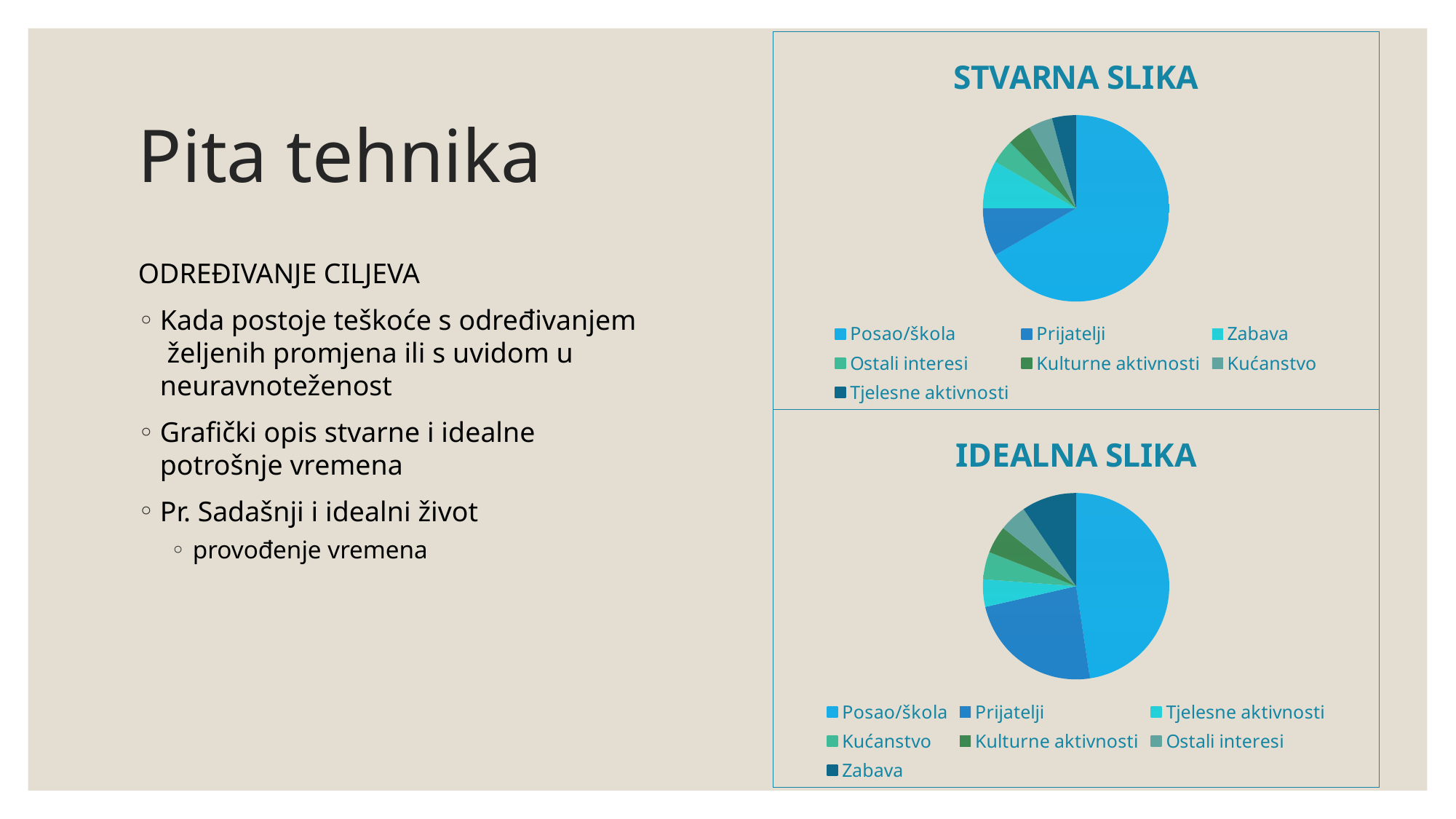
What kind of chart is the IDEALNA SLIKA chart? pie chart In the IDEALNA SLIKA chart, how many slices does the pie have? 7 In the IDEALNA SLIKA chart, which category has the largest slice? Posao/škola In the STVARNA SLIKA chart, which category has the largest slice? Posao/škola What is the title of the top chart on the slide? STVARNA SLIKA In the STVARNA SLIKA chart, which is larger, Posao/škola or Prijatelji? Posao/škola In the IDEALNA SLIKA chart, which is larger, Prijatelji or Zabava? Prijatelji In the IDEALNA SLIKA chart, which is larger, Posao/škola or Prijatelji? Posao/škola What kind of chart is the STVARNA SLIKA chart? pie chart What is the title of the bottom chart on the slide? IDEALNA SLIKA In the STVARNA SLIKA chart, how many categories does the legend list? 7